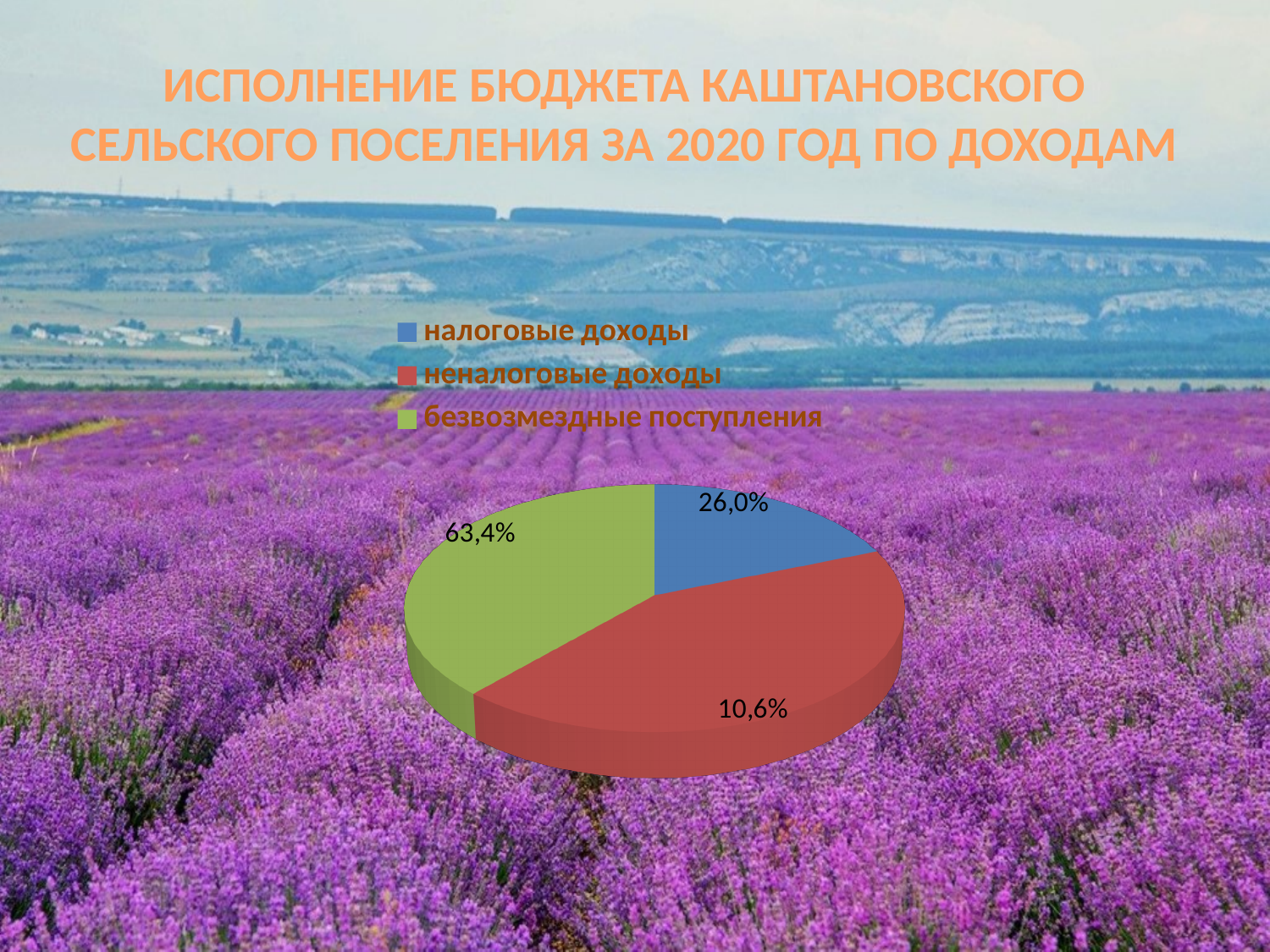
Which colour represents 'безвозмездные поступления' in the pie chart? green Which labelled share is larger: 'налоговые доходы' or 'безвозмездные поступления'? безвозмездные поступления What do the three labelled shares of the pie chart add up to? 100% What share of the pie is labelled for 'налоговые доходы'? 26,0% What share of the pie is labelled for 'безвозмездные поступления'? 63,4% Which category has the largest labelled share in the pie chart? безвозмездные поступления What kind of chart is shown on the slide? pie chart What share of the pie is labelled for 'неналоговые доходы'? 10,6% What is the difference in percentage points between the labelled shares of 'безвозмездные поступления' and 'налоговые доходы'? 37,4 How many entries does the legend of the pie chart list? 3 What is the title of the slide with the pie chart? ИСПОЛНЕНИЕ БЮДЖЕТА КАШТАНОВСКОГО СЕЛЬСКОГО ПОСЕЛЕНИЯ ЗА 2020 ГОД ПО ДОХОДАМ How many slices does the pie chart have? 3